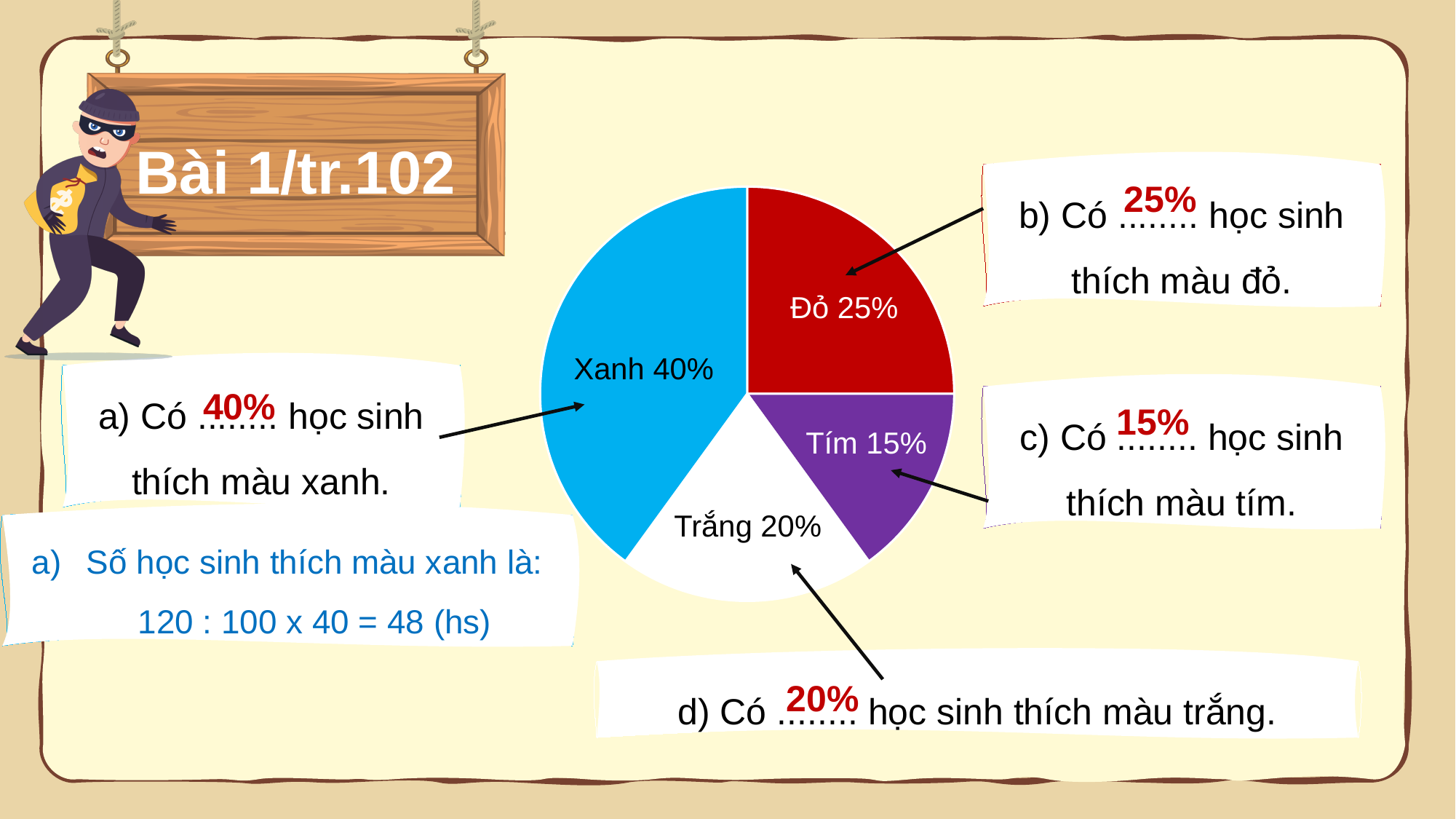
What percentage of the pie chart is labelled Đỏ? 25% What percentage of the pie chart is labelled Xanh? 40% How many slices does the pie chart have? 4 What colour is the Xanh slice of the pie chart? blue What is the difference in percentage points between the Xanh slice and the Đỏ slice? 15% What percentage of the pie chart is labelled Trắng? 20% What percentage of the pie chart is labelled Tím? 15% Which slice of the pie chart is the smallest? Tím Which slice of the pie chart is the largest? Xanh What is the combined share of the Đỏ and Tím slices? 40% Which slice is larger, Trắng or Tím? Trắng What kind of chart is shown on the slide? pie chart